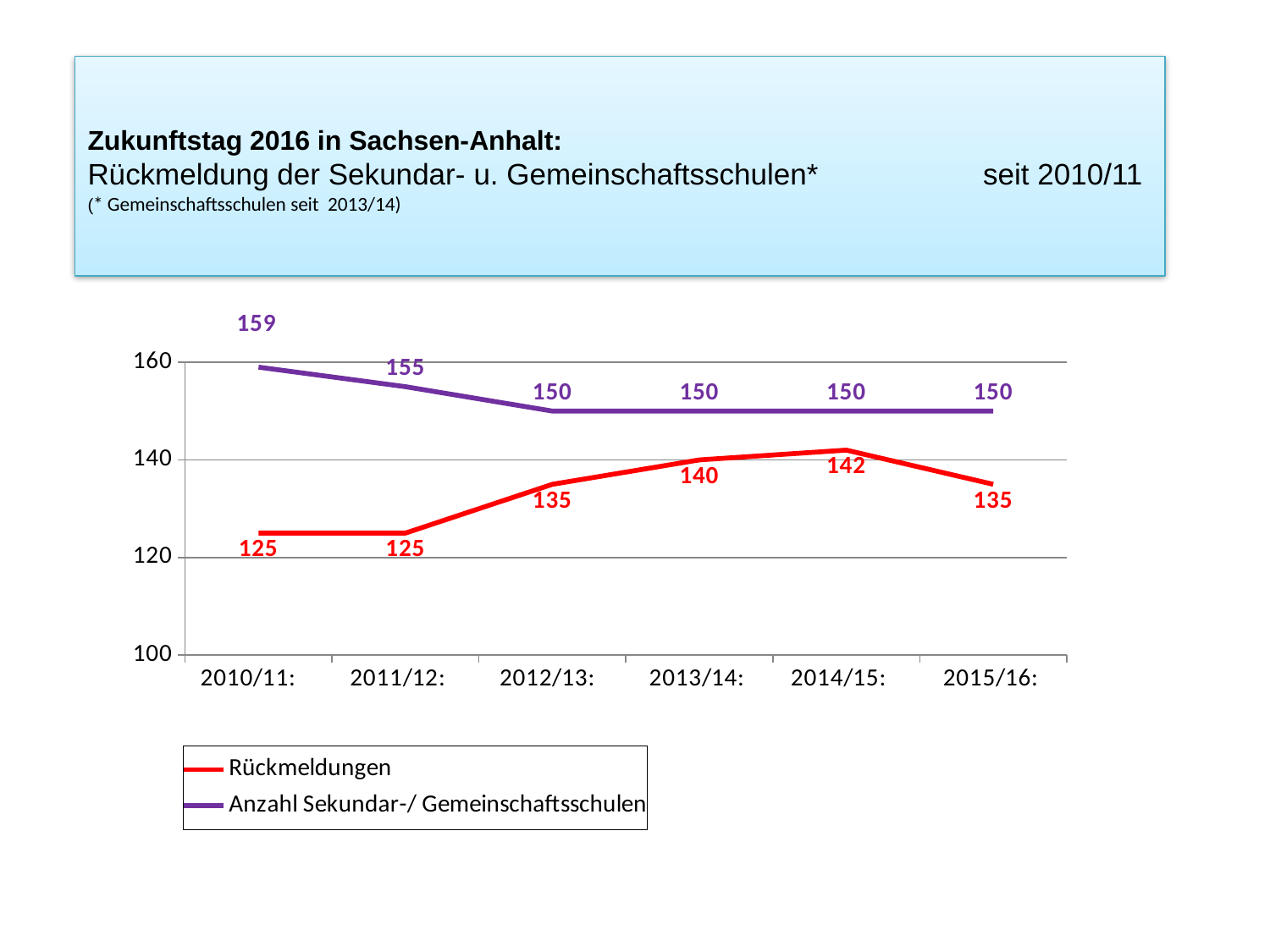
In which year is the Anzahl Sekundar-/ Gemeinschaftsschulen series at its highest? 2010/11 What is the difference between Anzahl Sekundar-/ Gemeinschaftsschulen and Rückmeldungen in 2010/11? 34 What is the value of Anzahl Sekundar-/ Gemeinschaftsschulen for 2011/12? 155 By how much did Rückmeldungen change from 2014/15 to 2015/16? 7 Does the Anzahl Sekundar-/ Gemeinschaftsschulen series rise or fall from 2010/11 to 2012/13? Fall In which year does the Rückmeldungen series reach its highest value? 2014/15 What is the value of Rückmeldungen for 2012/13? 135 Which is larger in 2013/14: Rückmeldungen or Anzahl Sekundar-/ Gemeinschaftsschulen? Anzahl Sekundar-/ Gemeinschaftsschulen What is the value of Rückmeldungen for 2014/15? 142 How many series does the legend list? 2 How many years are shown on the x axis? 6 What kind of chart is shown on the slide? Line chart